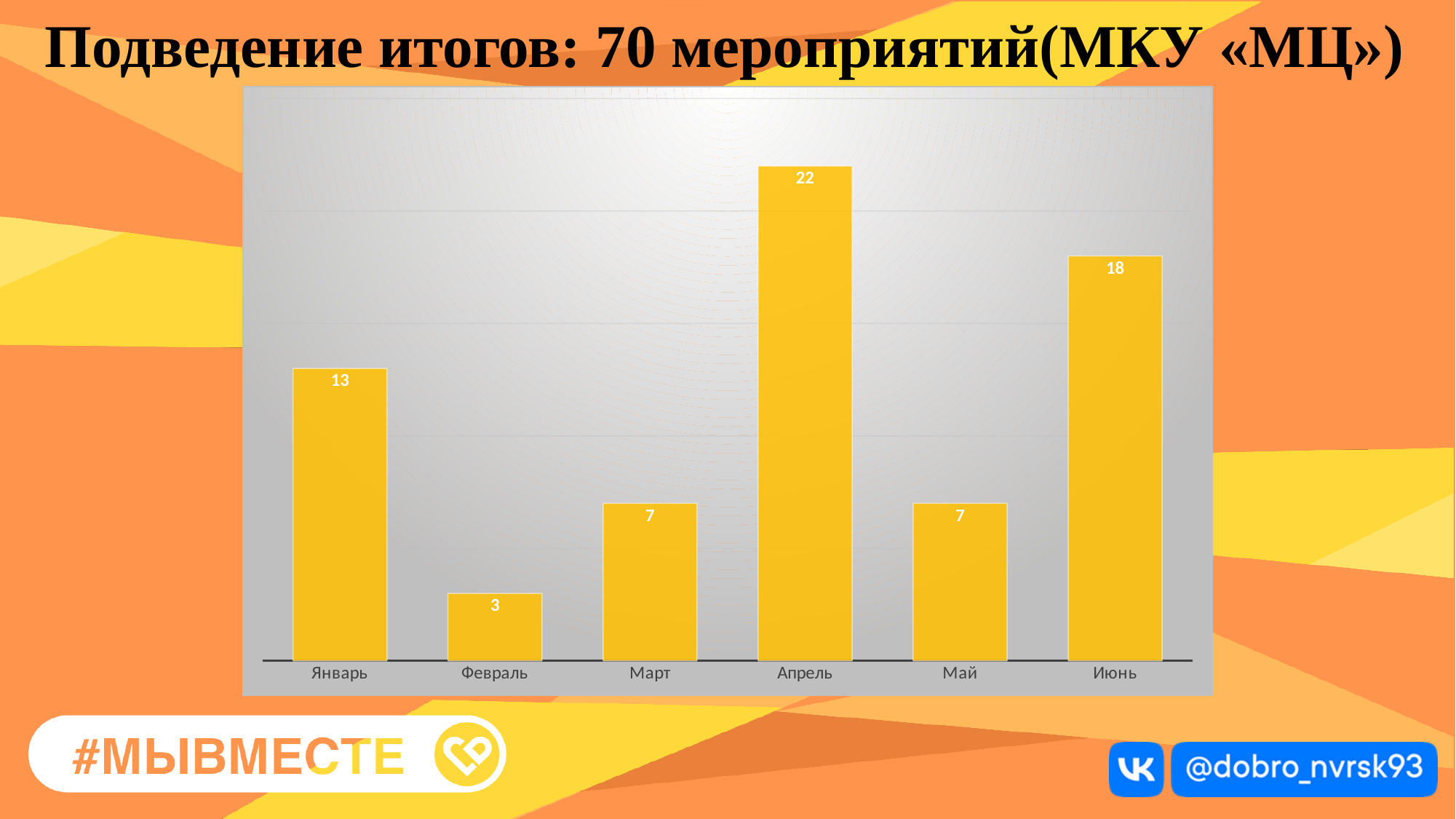
What is the value for Февраль? 3 What is the title of the slide? Подведение итогов: 70 мероприятий(МКУ «МЦ») What is the value for Январь? 13 Which is larger, the value for Январь or the value for Май? Январь What kind of chart is shown on the slide? Bar chart Which month has the highest value? Апрель What is the value for Апрель? 22 Which month has the lowest value? Февраль How many months are shown on the x axis? 6 What is the difference between the values for Январь and Февраль? 10 What is the value for Июнь? 18 What is the difference between the values for Апрель and Июнь? 4